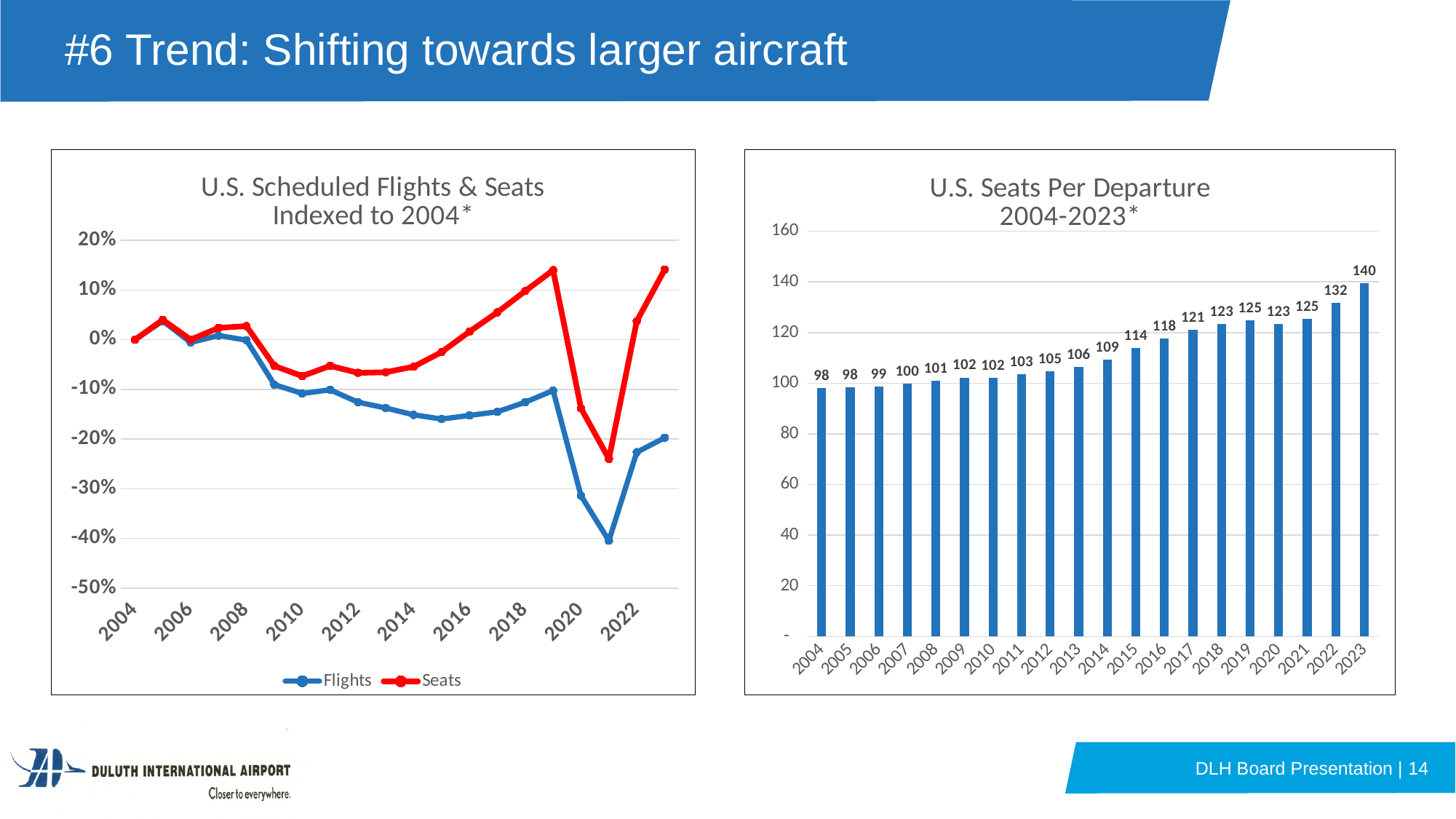
On the U.S. Seats Per Departure chart, which is larger, the value for 2019 or the value for 2020? 2019 On the U.S. Seats Per Departure chart, do the values generally rise or fall from 2004 to 2023? rise On the U.S. Seats Per Departure chart, which year has the highest value? 2023 What kind of chart is the U.S. Scheduled Flights & Seats Indexed to 2004 chart? line chart On the U.S. Seats Per Departure chart, what is the difference between the 2023 value and the 2004 value? 42 On the U.S. Seats Per Departure chart, what is the value for 2023? 140 On the U.S. Scheduled Flights & Seats chart, is the Flights value for 2021 greater or less than -30%? less How many series does the legend of the U.S. Scheduled Flights & Seats chart list? 2 On the U.S. Scheduled Flights & Seats chart, which colour is the Seats line? red On the U.S. Seats Per Departure chart, what is the value for 2015? 114 On the U.S. Seats Per Departure chart, how many years are shown? 20 What kind of chart is the U.S. Seats Per Departure chart? bar chart